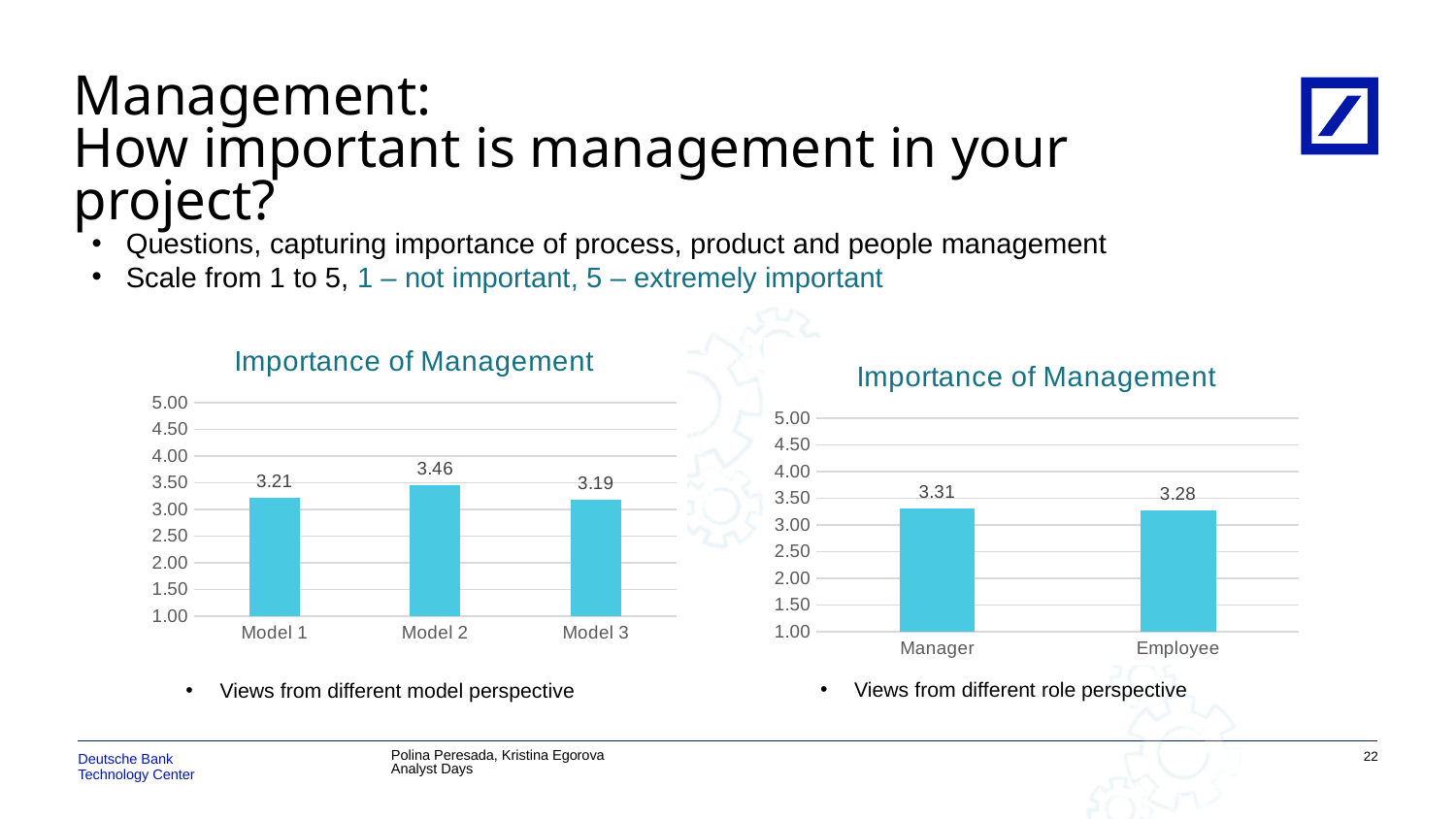
In the right chart (Manager and Employee), what is the value for Employee? 3.28 What type of chart is the right chart (Manager and Employee)? bar chart In the left chart (Model 1 to Model 3), what is the value for Model 3? 3.19 In the left chart (Model 1 to Model 3), is the value for Model 2 greater or less than 3.50? less In the left chart (Model 1 to Model 3), how many categories are shown? 3 In the left chart (Model 1 to Model 3), what is the difference between Model 2 and Model 3? 0.27 In the left chart (Model 1 to Model 3), what is the value for Model 1? 3.21 In the right chart (Manager and Employee), what is the value for Manager? 3.31 In the left chart (Model 1 to Model 3), what is the value for Model 2? 3.46 In the right chart (Manager and Employee), what is the difference between the Manager and Employee values? 0.03 In the left chart (Model 1 to Model 3), which model has the highest value? Model 2 What is the title of the left chart? Importance of Management